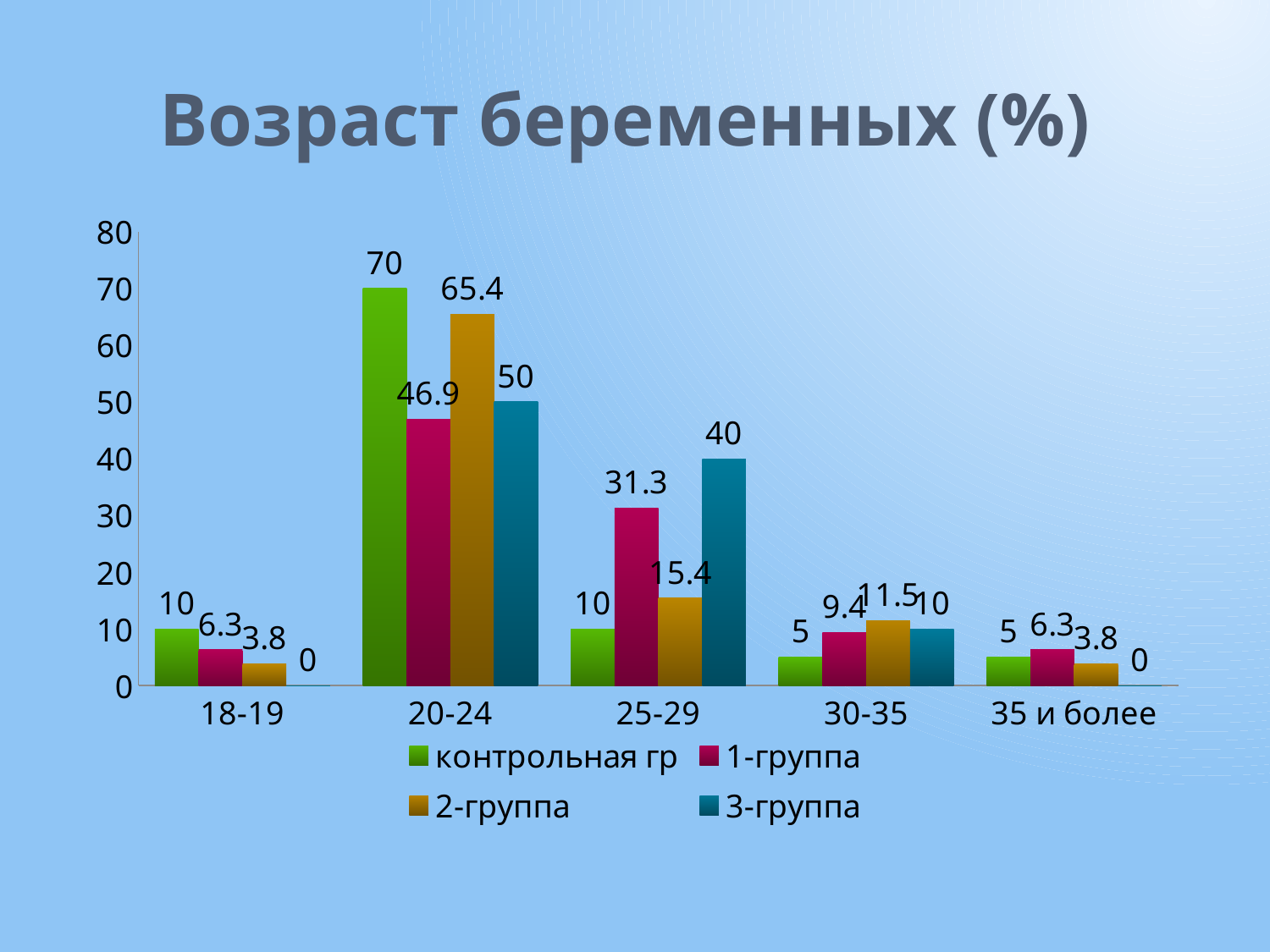
What is the value for 2-группа in the 30-35 category? 11.5 How many age categories are shown on the x axis? 5 Which age category has the lowest value for 3-группа? 18-19 and 35 и более (both 0) What is the value for 3-группа in the 25-29 category? 40 What is the value for 1-группа in the 18-19 category? 6.3 How many series does the legend list? 4 What is the difference between контрольная гр and 1-группа in the 20-24 category? 23.1 What type of chart is shown on the slide? bar chart What is the title of the chart? Возраст беременных (%) What is the value for контрольная гр in the 20-24 category? 70 In the 25-29 category, which is larger: 1-группа or 2-группа? 1-группа Which age category has the highest value for 1-группа? 20-24